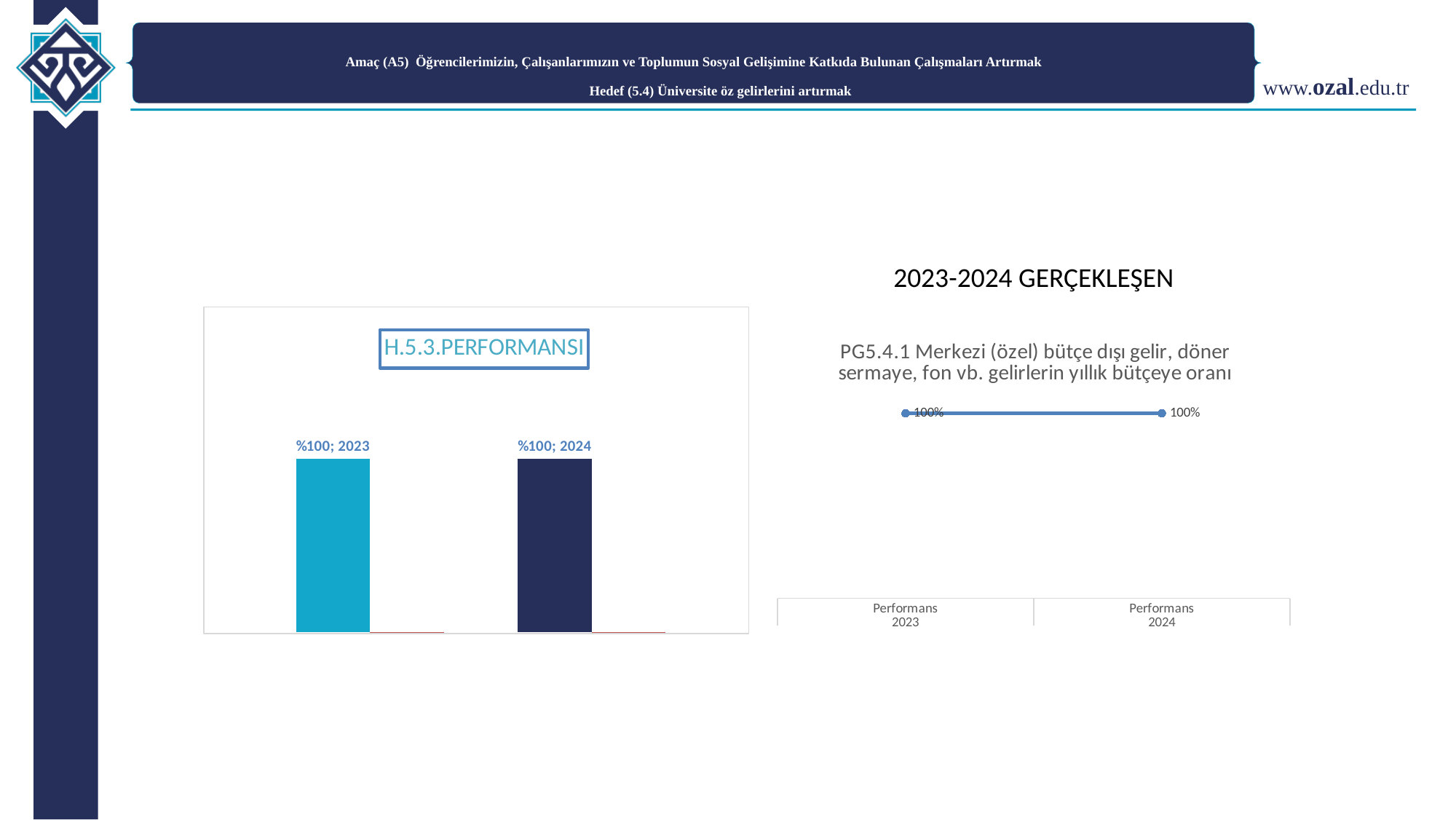
What kind of chart is the left chart titled H.5.3.PERFORMANSI? bar chart In the left chart titled H.5.3.PERFORMANSI, what is the value labelled for 2024? %100 In the left chart titled H.5.3.PERFORMANSI, what is the value labelled for 2023? %100 How many data points are plotted in the right chart (PG5.4.1)? 2 What heading appears above the right chart? 2023-2024 GERÇEKLEŞEN What kind of chart is the right chart titled PG5.4.1 Merkezi (özel) bütçe dışı gelir, döner sermaye, fon vb. gelirlerin yıllık bütçeye oranı? line chart In the right chart (PG5.4.1), what is the value for Performans 2024? 100% In the right chart (PG5.4.1), do the values rise, fall or stay the same from Performans 2023 to Performans 2024? stay the same What is the title of the left chart? H.5.3.PERFORMANSI How many bars are shown in the left chart titled H.5.3.PERFORMANSI? 2 In the left chart titled H.5.3.PERFORMANSI, what is the difference between the 2023 and 2024 values? 0 In the right chart (PG5.4.1), what is the value for Performans 2023? 100%